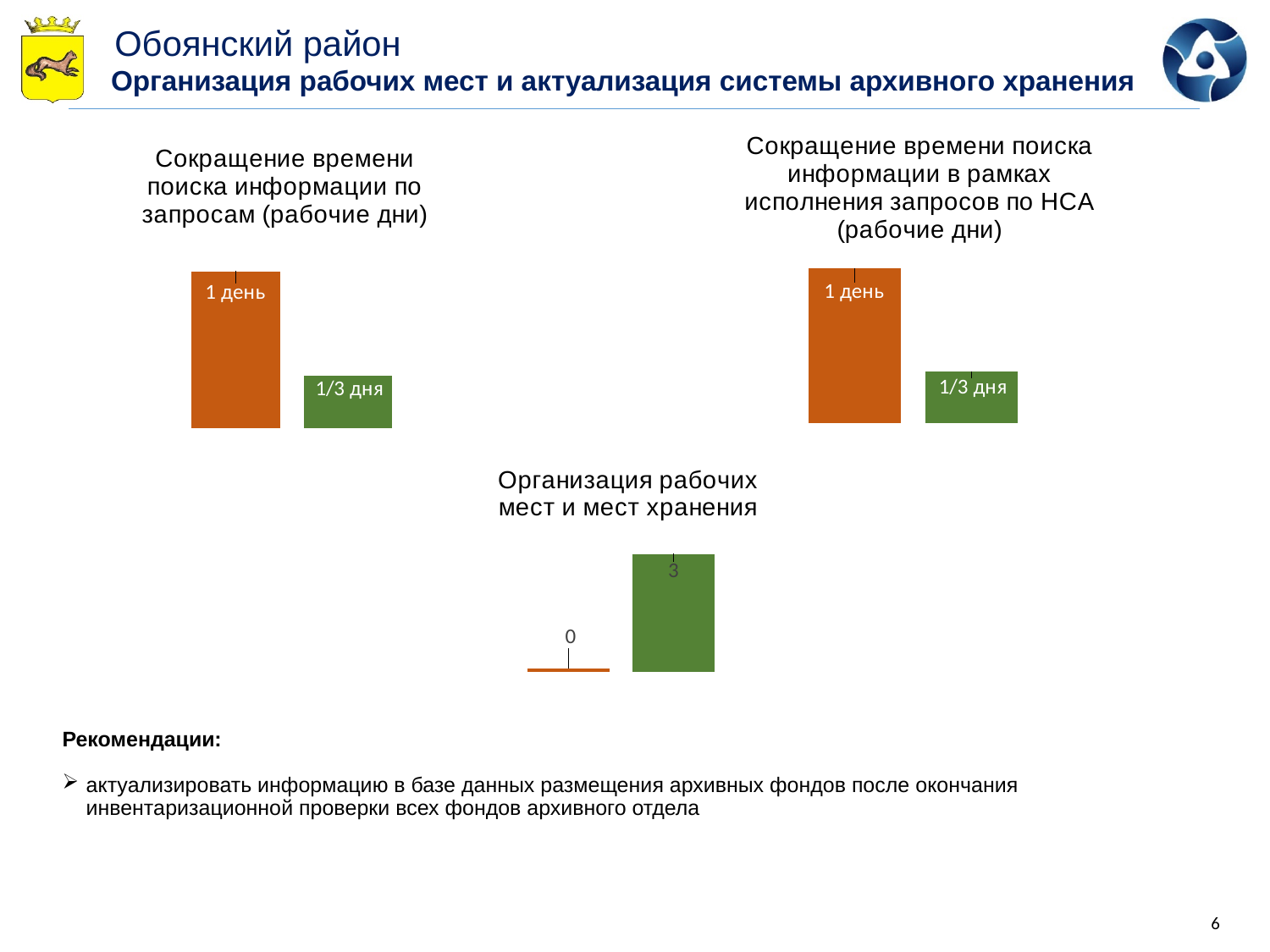
In the chart titled "Организация рабочих мест и мест хранения", which bar is higher, the orange one or the green one? the green one In the chart titled "Организация рабочих мест и мест хранения", what is the value of the right (green) bar? 3 In the chart titled "Сокращение времени поиска информации в рамках исполнения запросов по НСА (рабочие дни)", what is the data label on the right (green) bar? 1/3 дня What type of chart is the chart titled "Организация рабочих мест и мест хранения"? bar chart In the chart titled "Организация рабочих мест и мест хранения", what is the value of the left (orange) bar? 0 In the chart titled "Сокращение времени поиска информации по запросам (рабочие дни)", what is the data label on the left (orange) bar? 1 день In the chart titled "Сокращение времени поиска информации по запросам (рабочие дни)", what is the data label on the right (green) bar? 1/3 дня How many charts are shown on the slide? 3 In the chart titled "Сокращение времени поиска информации по запросам (рабочие дни)", which bar is taller, the orange one or the green one? the orange one How many bars are in the chart titled "Сокращение времени поиска информации в рамках исполнения запросов по НСА (рабочие дни)"? 2 In the chart titled "Организация рабочих мест и мест хранения", what is the difference between the green bar and the orange bar? 3 In the chart titled "Сокращение времени поиска информации в рамках исполнения запросов по НСА (рабочие дни)", what is the data label on the left (orange) bar? 1 день